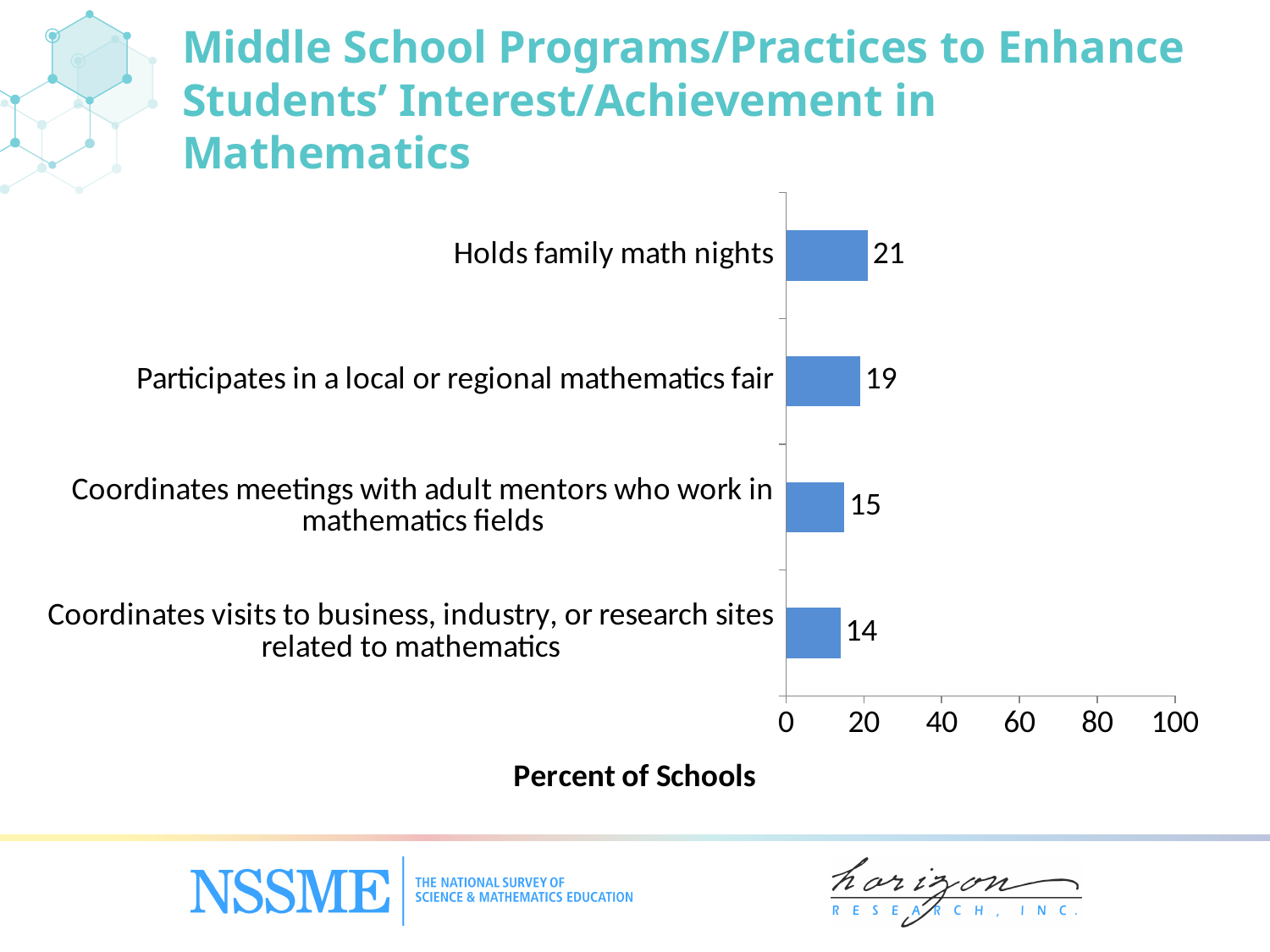
Is the value for 'Holds family math nights' greater or less than 40? less How many programs/practices are shown in the chart? 4 What is the value for 'Coordinates visits to business, industry, or research sites related to mathematics'? 14 What percent of schools hold family math nights? 21 What is the value for 'Participates in a local or regional mathematics fair'? 19 Which program/practice has the lowest percent of schools? Coordinates visits to business, industry, or research sites related to mathematics What kind of chart is shown on the slide? bar chart What is the label of the horizontal axis? Percent of Schools Which program/practice has the highest percent of schools? Holds family math nights Which is larger: the value for 'Participates in a local or regional mathematics fair' or for 'Coordinates meetings with adult mentors who work in mathematics fields'? Participates in a local or regional mathematics fair What percent of schools coordinate meetings with adult mentors who work in mathematics fields? 15 What is the difference between the values for 'Holds family math nights' and 'Coordinates visits to business, industry, or research sites related to mathematics'? 7